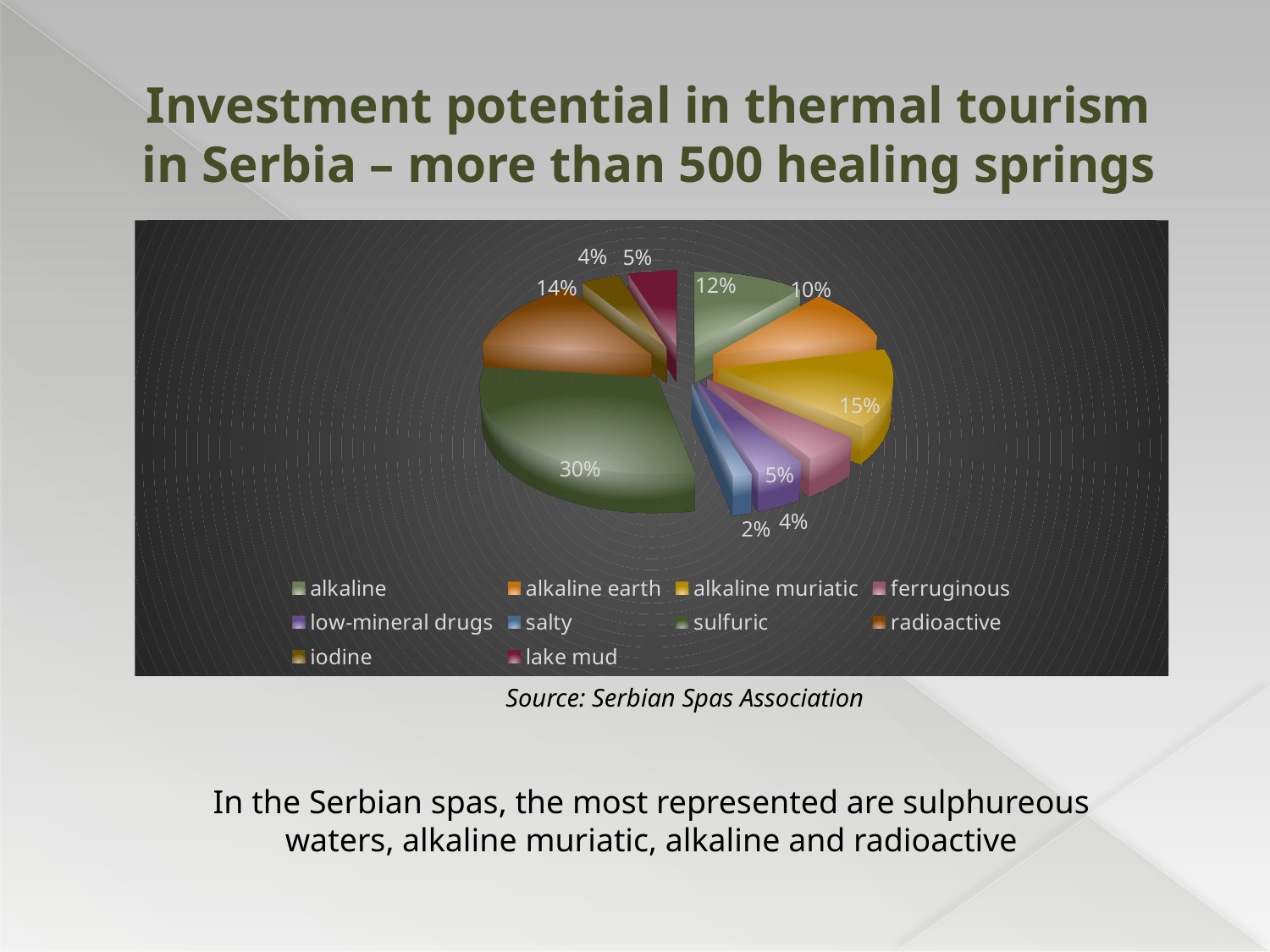
Which category has the smallest slice of the pie? salty What percentage is shown for alkaline earth springs? 10% What percentage is shown for radioactive springs? 14% What percentage is shown for salty springs? 2% How many percentage points larger is the sulfuric slice than the alkaline muriatic slice? 15 percentage points What type of chart is shown on the slide? pie chart What percentage is shown for alkaline muriatic springs? 15% What source is cited below the chart? Serbian Spas Association Which category has the largest slice of the pie? sulfuric What share of the pie does the sulfuric slice represent? 30% Which slice is larger, alkaline or alkaline earth? alkaline How many categories does the legend of the pie chart list? 10